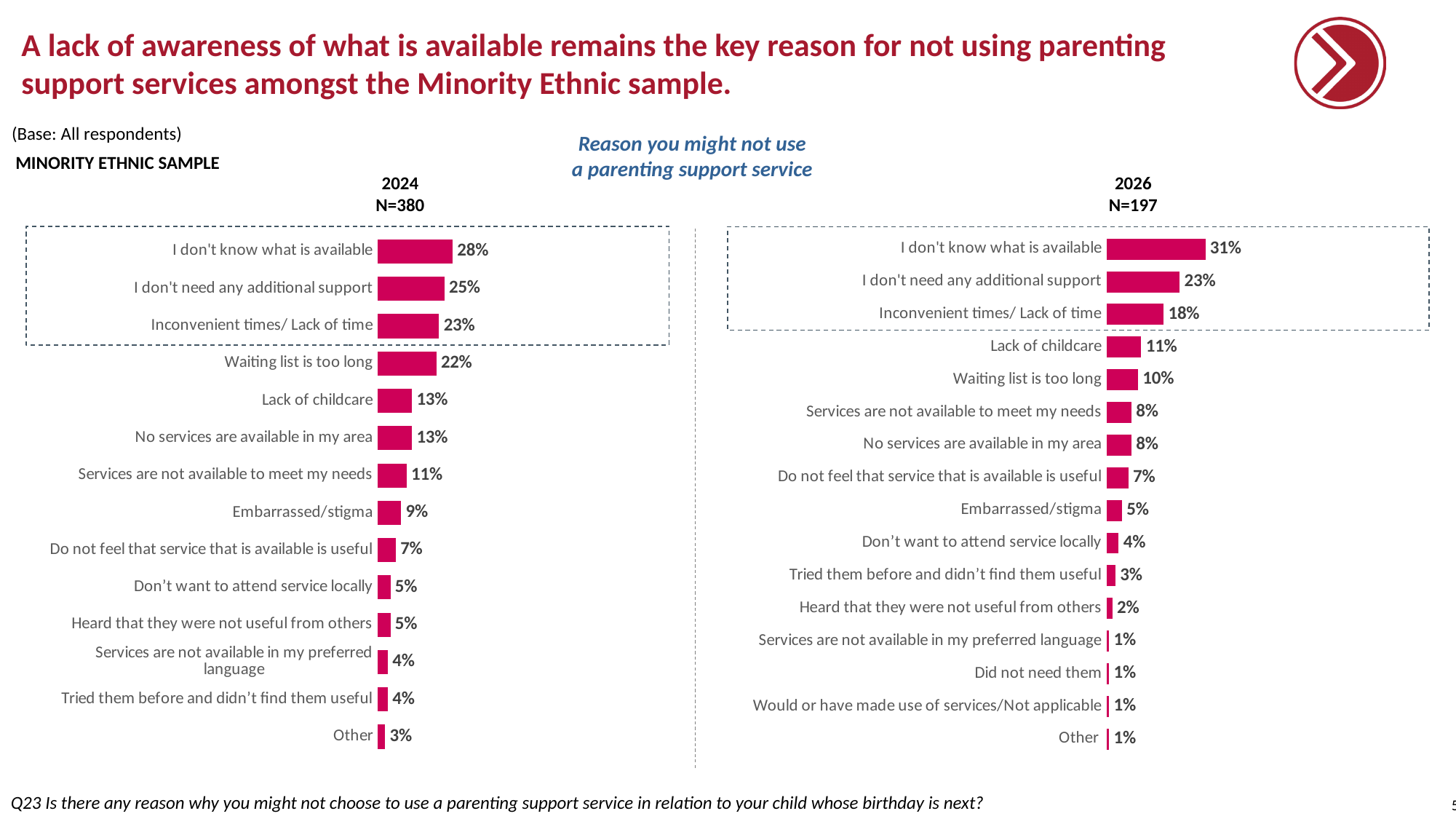
In the 2024 chart, which reason has the lowest percentage? Other In the 2024 chart, what percentage said 'I don't know what is available'? 28% What type of chart is used on this slide? Bar chart What is the sample size (N) for the 2026 chart? 197 What is the difference between the 2026 and 2024 values for 'I don't know what is available'? 3 percentage points In the 2026 chart, what percentage said 'Inconvenient times/ Lack of time'? 18% Which is larger: 'Lack of childcare' in 2024 or 'Lack of childcare' in 2026? 2024 How many reasons are listed in the 2026 chart? 16 In the 2026 chart, which reason has the highest percentage? I don't know what is available How many reasons are listed in the 2024 chart? 14 In the 2024 chart, what is the difference between 'Waiting list is too long' and 'Lack of childcare'? 9 percentage points In the 2024 chart, what percentage said 'Embarrassed/stigma'? 9%